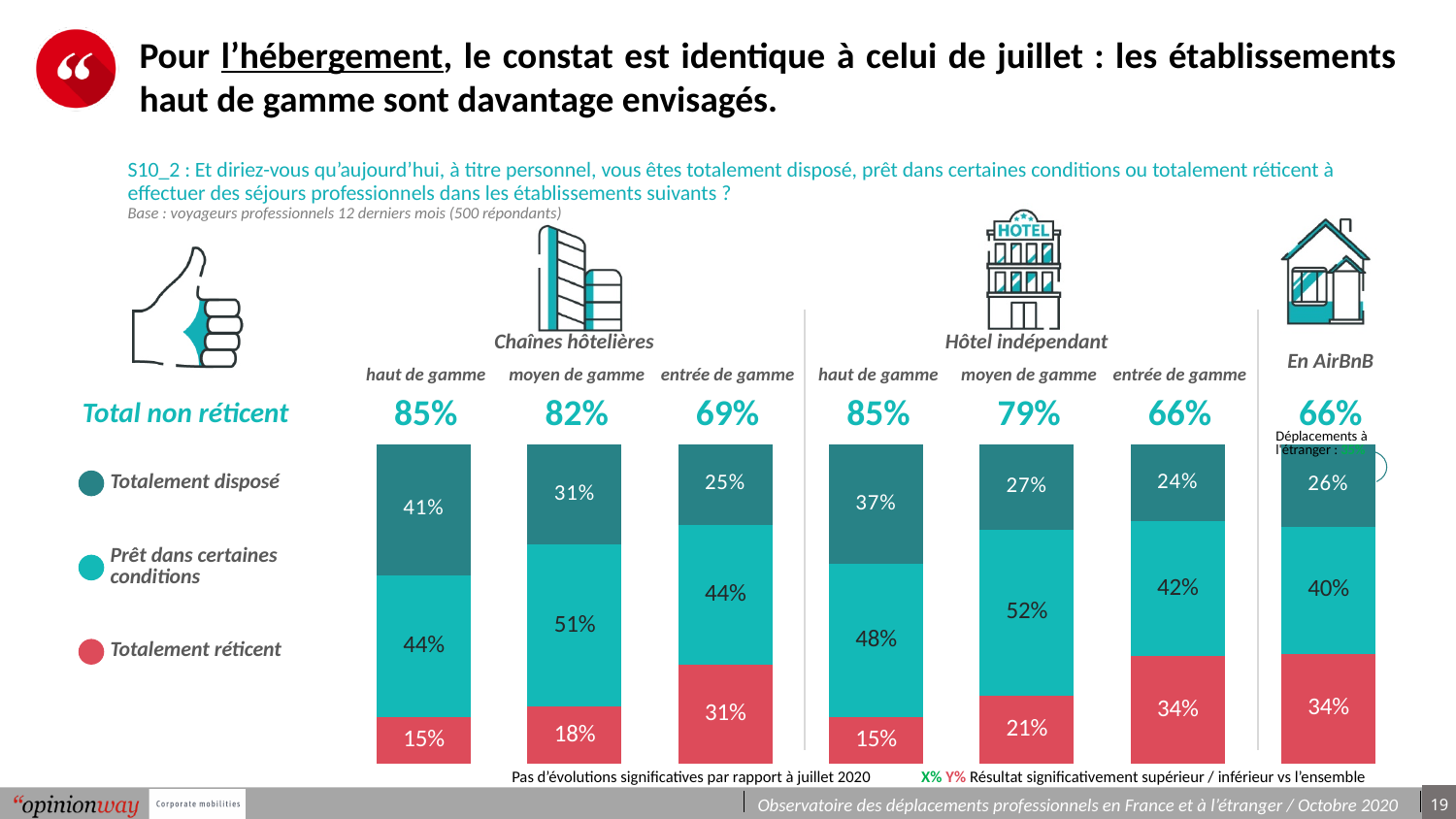
Which category has the highest 'Totalement disposé' value? Chaînes hôtelières haut de gamme What is the 'Totalement réticent' value for Hôtel indépendant moyen de gamme? 21% What is the 'Prêt dans certaines conditions' value for En AirBnB? 40% What is the difference between the 'Totalement réticent' values for Chaînes hôtelières entrée de gamme and Chaînes hôtelières haut de gamme? 16% How many series does the legend list? 3 What percentage of respondents are 'Totalement disposé' for Chaînes hôtelières haut de gamme? 41% What kind of chart is shown on the slide? Stacked bar chart What is the 'Total non réticent' value for Chaînes hôtelières entrée de gamme? 69% How many categories (bars) are shown in the chart? 7 Which is larger: the 'Prêt dans certaines conditions' value for Hôtel indépendant moyen de gamme or for Chaînes hôtelières moyen de gamme? Hôtel indépendant moyen de gamme What is the total of the 'Totalement disposé' and 'Prêt dans certaines conditions' segments for Hôtel indépendant haut de gamme? 85% Which category has the lowest 'Totalement disposé' value? Hôtel indépendant entrée de gamme